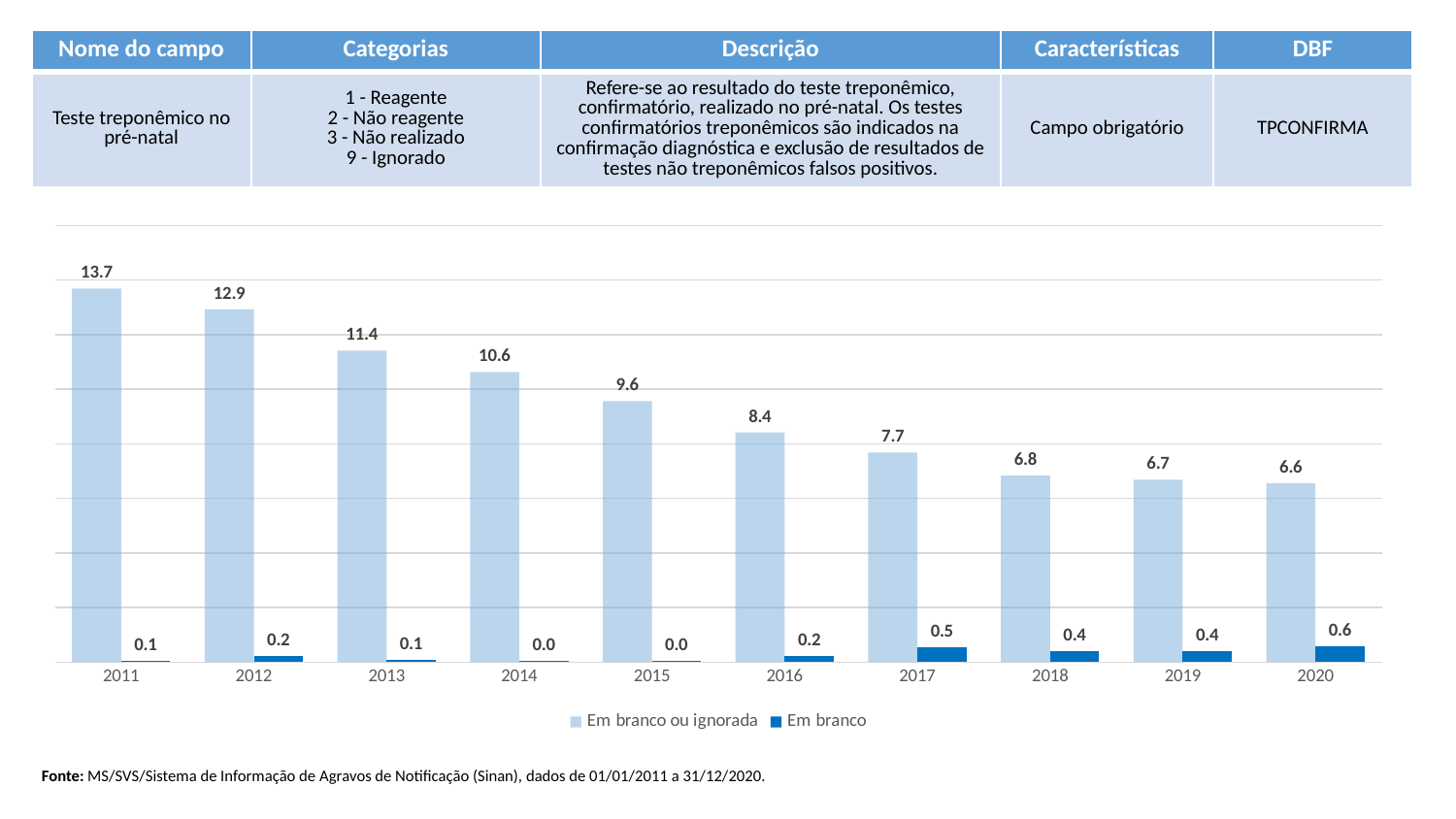
What is the value for "Em branco ou ignorada" in 2011? 13.7 How many series does the chart legend list? 2 Which year has the lowest value for "Em branco ou ignorada"? 2020 What is the value for "Em branco ou ignorada" in 2020? 6.6 Which year has the highest value for "Em branco"? 2020 What kind of chart is shown on the slide? Bar chart What is the value for "Em branco" in 2017? 0.5 How many years are shown on the x axis of the chart? 10 Which is larger: the "Em branco ou ignorada" value for 2015 or for 2016? 2015 Do the "Em branco ou ignorada" values rise or fall from 2011 to 2020? Fall What is the difference between the "Em branco ou ignorada" values for 2011 and 2012? 0.8 Which year has the highest value for "Em branco ou ignorada"? 2011